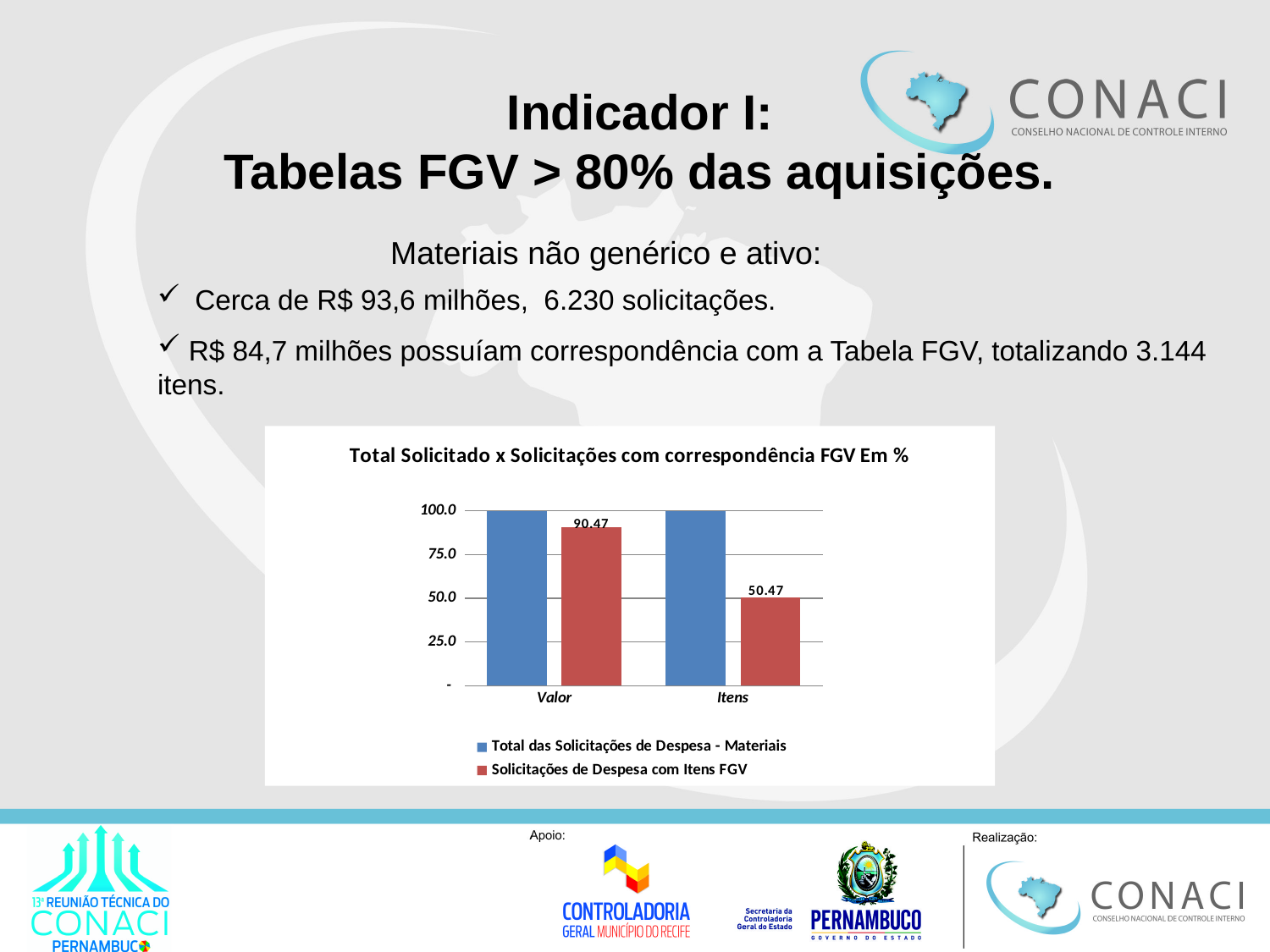
What is the difference between the 'Solicitações de Despesa com Itens FGV' values for 'Valor' and 'Itens'? 40.00 Is the 'Solicitações de Despesa com Itens FGV' value for 'Itens' greater or less than 75.0? less What is the value of the 'Solicitações de Despesa com Itens FGV' series for the 'Itens' category? 50.47 What is the title of the chart? Total Solicitado x Solicitações com correspondência FGV Em % Is the 'Solicitações de Despesa com Itens FGV' value for 'Valor' greater or less than 75.0? greater What type of chart is shown on the slide? bar chart For the 'Solicitações de Despesa com Itens FGV' series, which category has the lower value? Itens How many series does the chart legend list? 2 How many categories are shown on the x axis of the chart? 2 What is the value of the 'Solicitações de Despesa com Itens FGV' series for the 'Valor' category? 90.47 What is the value of the 'Total das Solicitações de Despesa - Materiais' series for the 'Valor' category? 100.0 For the 'Solicitações de Despesa com Itens FGV' series, which category has the higher value? Valor